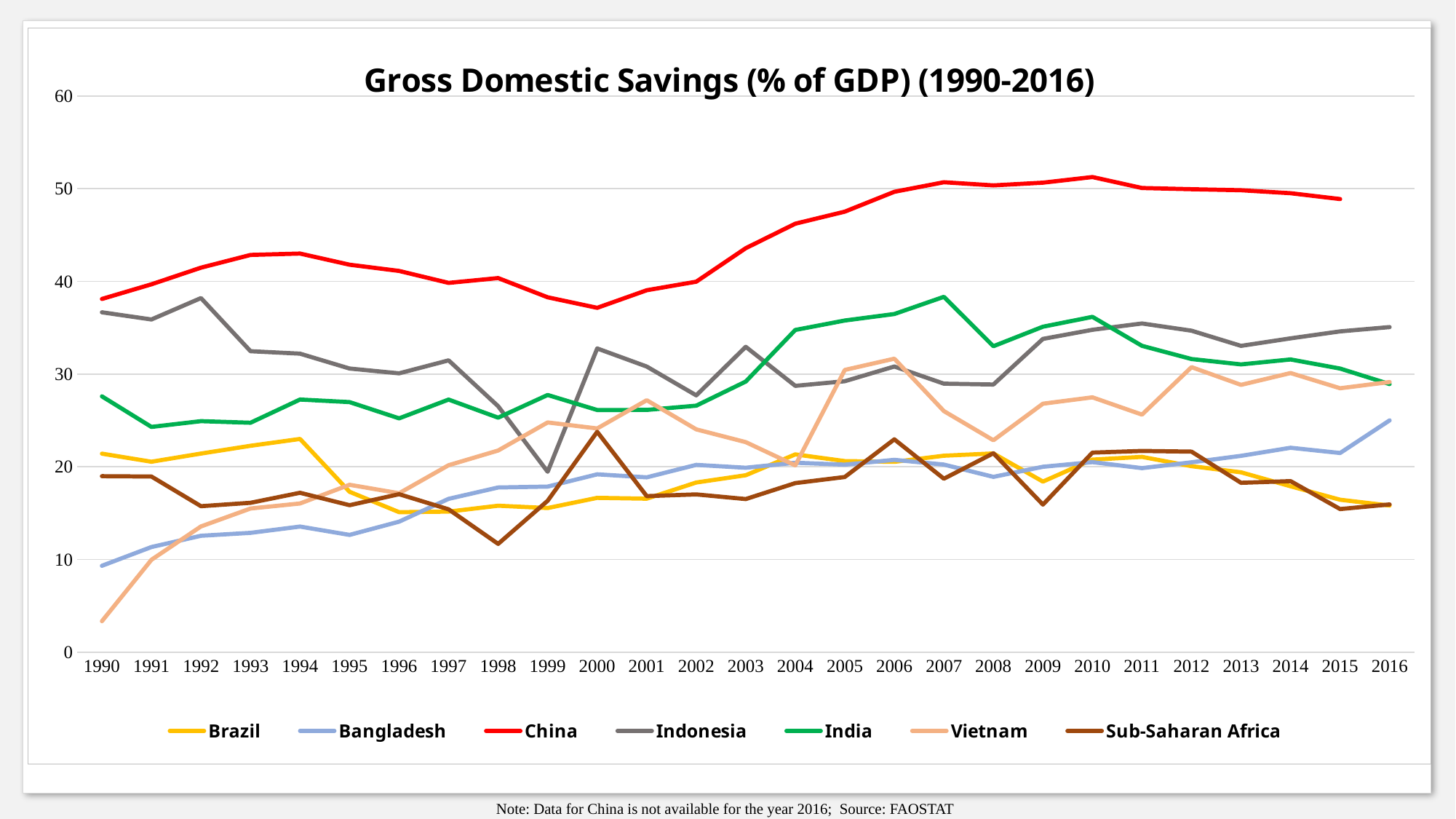
Does the value for China rise or fall from 2000 to 2010? rise Which series has the highest value in 2010? China Is the value for Vietnam in 1990 greater or less than 10? less Is the value for China in 2010 greater or less than 50? greater In 2000, which is larger: the value for Brazil or the value for Sub-Saharan Africa? Sub-Saharan Africa Is the value for Bangladesh in 2016 greater or less than 20? greater How many years are plotted along the x axis? 27 In 2007, which is larger: the value for India or the value for Indonesia? India How many series does the legend list? 7 Which series has the lowest value in 1990? Vietnam What kind of chart is shown on the slide? line chart What is the title of the chart? Gross Domestic Savings (% of GDP) (1990-2016)